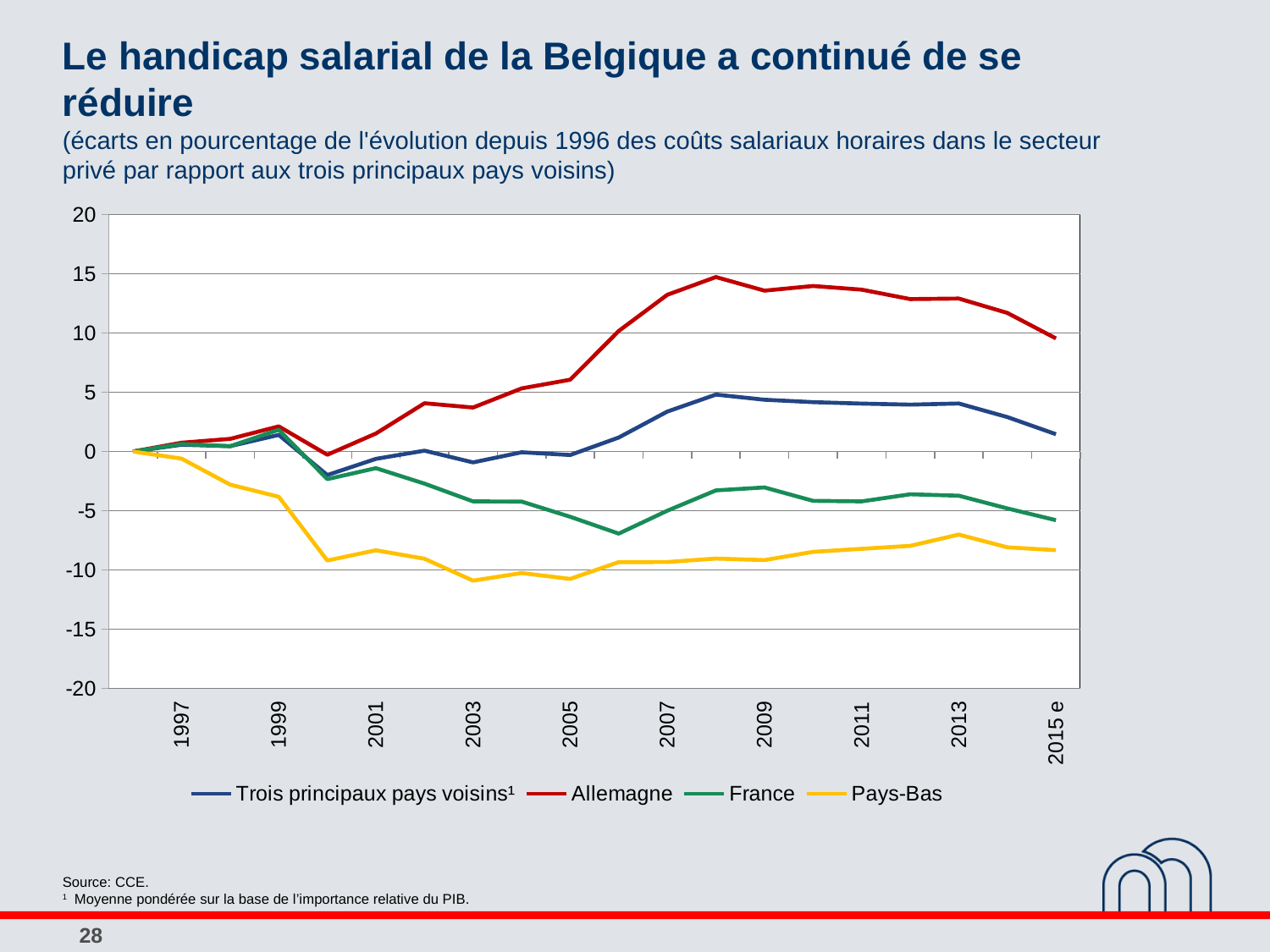
How many series does the legend list? 4 Is the value for Trois principaux pays voisins in 2008 greater or less than 0? greater Is the value for Allemagne in 2008 greater or less than 10? greater In 2015 e, which is larger: the value for Allemagne or the value for France? Allemagne Is the value for Pays-Bas in 2003 greater or less than -5? less Which series has the lowest value in 2015 e? Pays-Bas What is the last label on the x axis? 2015 e Which series has the highest value in 2015 e? Allemagne What colour is the Allemagne line in the legend? red What kind of chart is shown on the slide? line chart Does the Allemagne line rise or fall between 2008 and 2015 e? fall